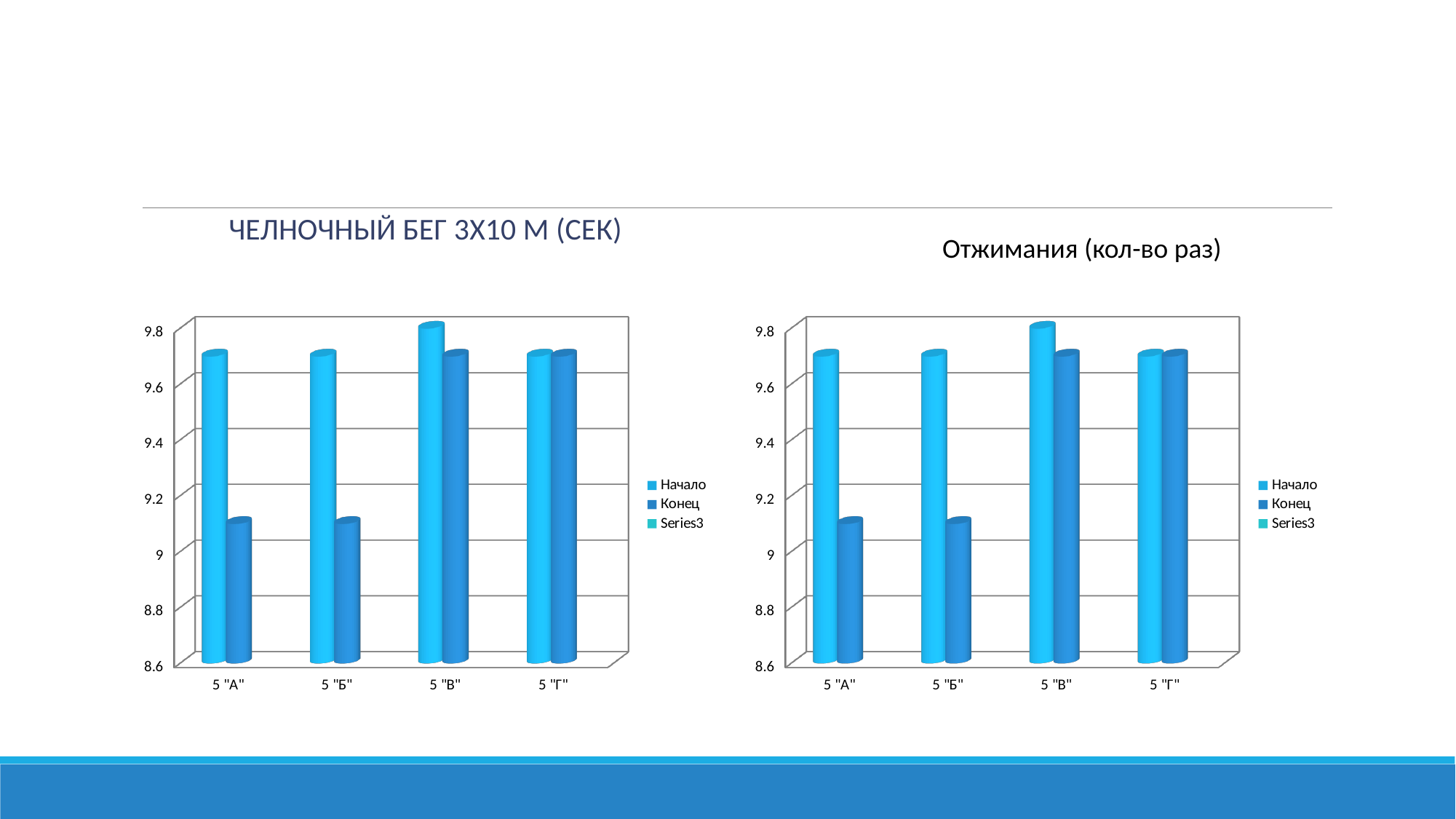
What kind of chart is the left chart, titled "ЧЕЛНОЧНЫЙ БЕГ 3Х10 М (СЕК)"? bar chart In the right chart (Отжимания (кол-во раз)), which category has the highest Начало value? 5 "В" In the left chart (ЧЕЛНОЧНЫЙ БЕГ 3Х10 М (СЕК)), for 5 "Б", which is larger: Начало or Конец? Начало In the left chart (ЧЕЛНОЧНЫЙ БЕГ 3Х10 М (СЕК)), how many series does the legend list? 3 In the left chart (ЧЕЛНОЧНЫЙ БЕГ 3Х10 М (СЕК)), is the Конец value for 5 "А" greater or less than 9.4? less In the left chart (ЧЕЛНОЧНЫЙ БЕГ 3Х10 М (СЕК)), is the Начало value for 5 "В" greater or less than 9.6? greater In the left chart (ЧЕЛНОЧНЫЙ БЕГ 3Х10 М (СЕК)), which category has the highest Начало value? 5 "В" What is the title of the right chart? Отжимания (кол-во раз) In the right chart (Отжимания (кол-во раз)), is the Конец value for 5 "Б" greater or less than 9.2? less In the left chart (ЧЕЛНОЧНЫЙ БЕГ 3Х10 М (СЕК)), how many categories are shown on the x axis? 4 What are the three legend entries in the left chart (ЧЕЛНОЧНЫЙ БЕГ 3Х10 М (СЕК))? Начало, Конец, Series3